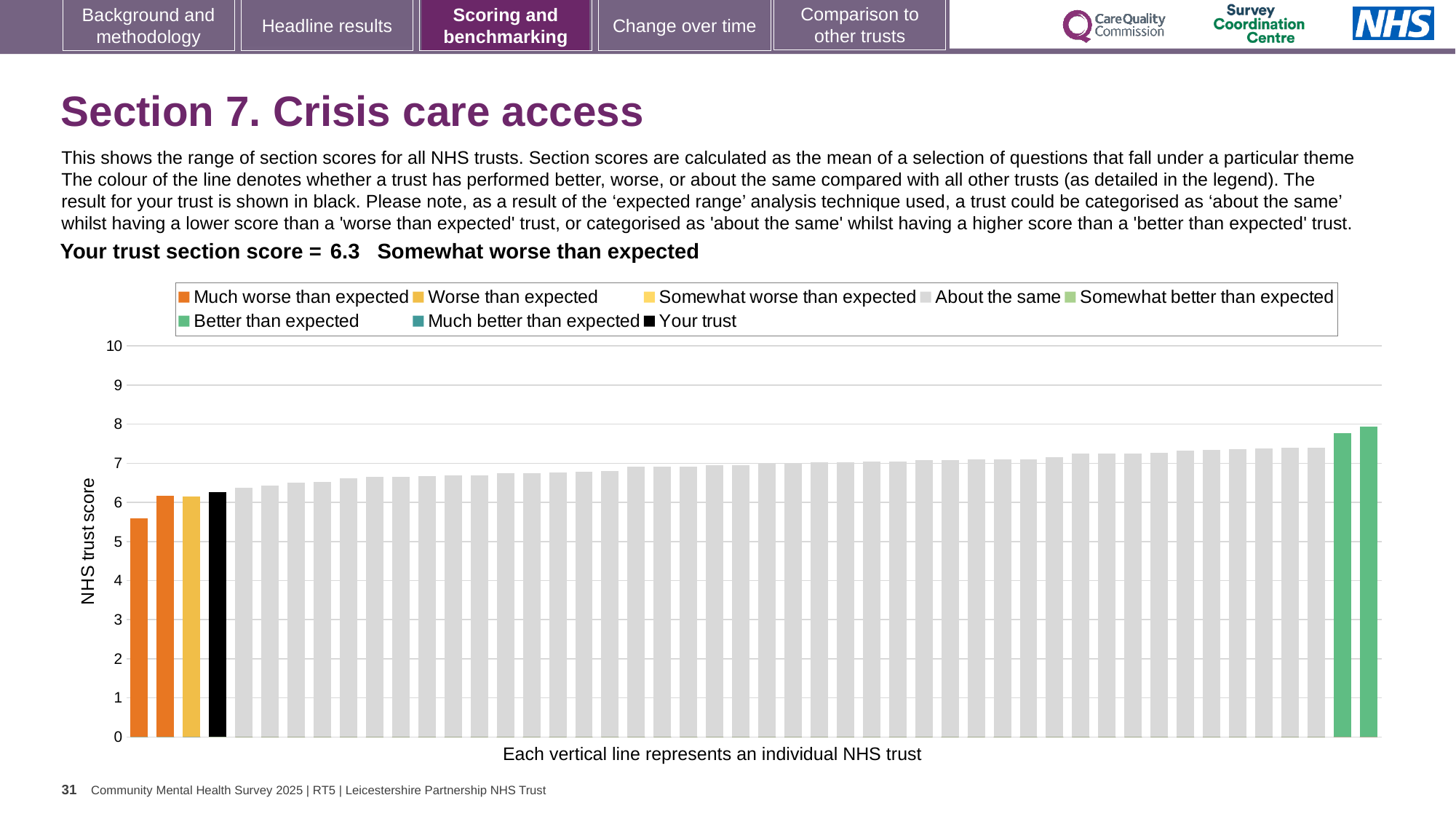
Is the value of the black 'Your trust' bar greater or less than 5? greater How many entries does the chart legend list? 8 How many bars are coloured green (Better than expected)? 2 Which category is your trust's section score placed in? Somewhat worse than expected What is the section score for your trust shown on the slide? 6.3 What is the label on the vertical axis of the chart? NHS trust score How many bars are coloured orange (Much worse than expected)? 2 Is the value of the highest bar in the chart greater or less than 7? greater Is the value of the lowest bar in the chart greater or less than 6? less Do the bar values rise or fall from left to right along the x axis? rise What kind of chart is shown on the slide? bar chart